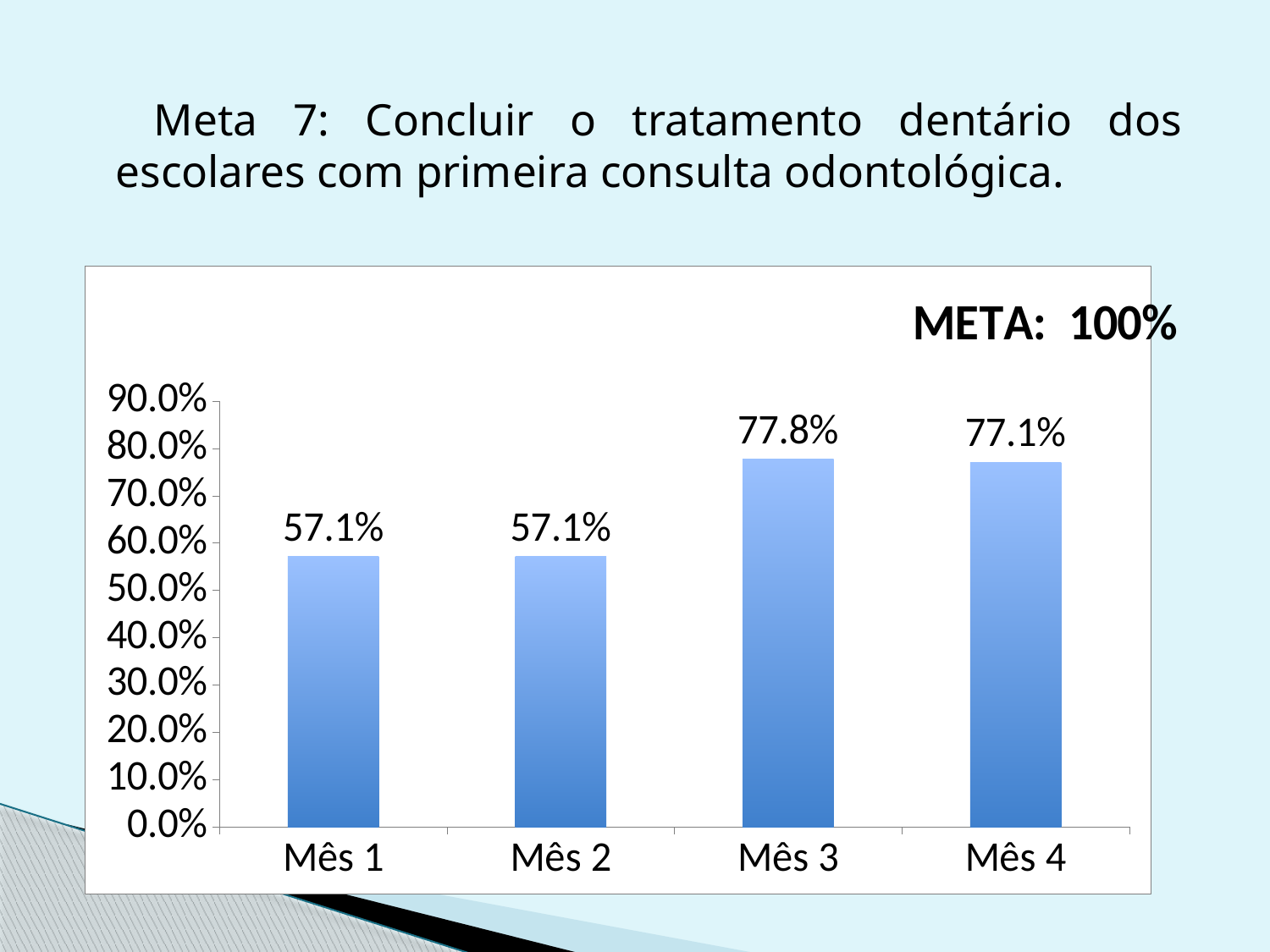
Which month has the highest value? Mês 3 What is the value for Mês 1? 57.1% What kind of chart is shown on the slide? bar chart What is the value for Mês 3? 77.8% How many months are shown on the x axis? 4 Is the value for Mês 2 greater or less than 50.0%? greater Do the values rise or fall from Mês 2 to Mês 3? rise What target (META) is stated on the chart? 100% Which is larger, the value for Mês 2 or the value for Mês 4? Mês 4 What is the difference between the values for Mês 3 and Mês 4? 0.7% What is the difference between the values for Mês 3 and Mês 1? 20.7% What is the value for Mês 4? 77.1%